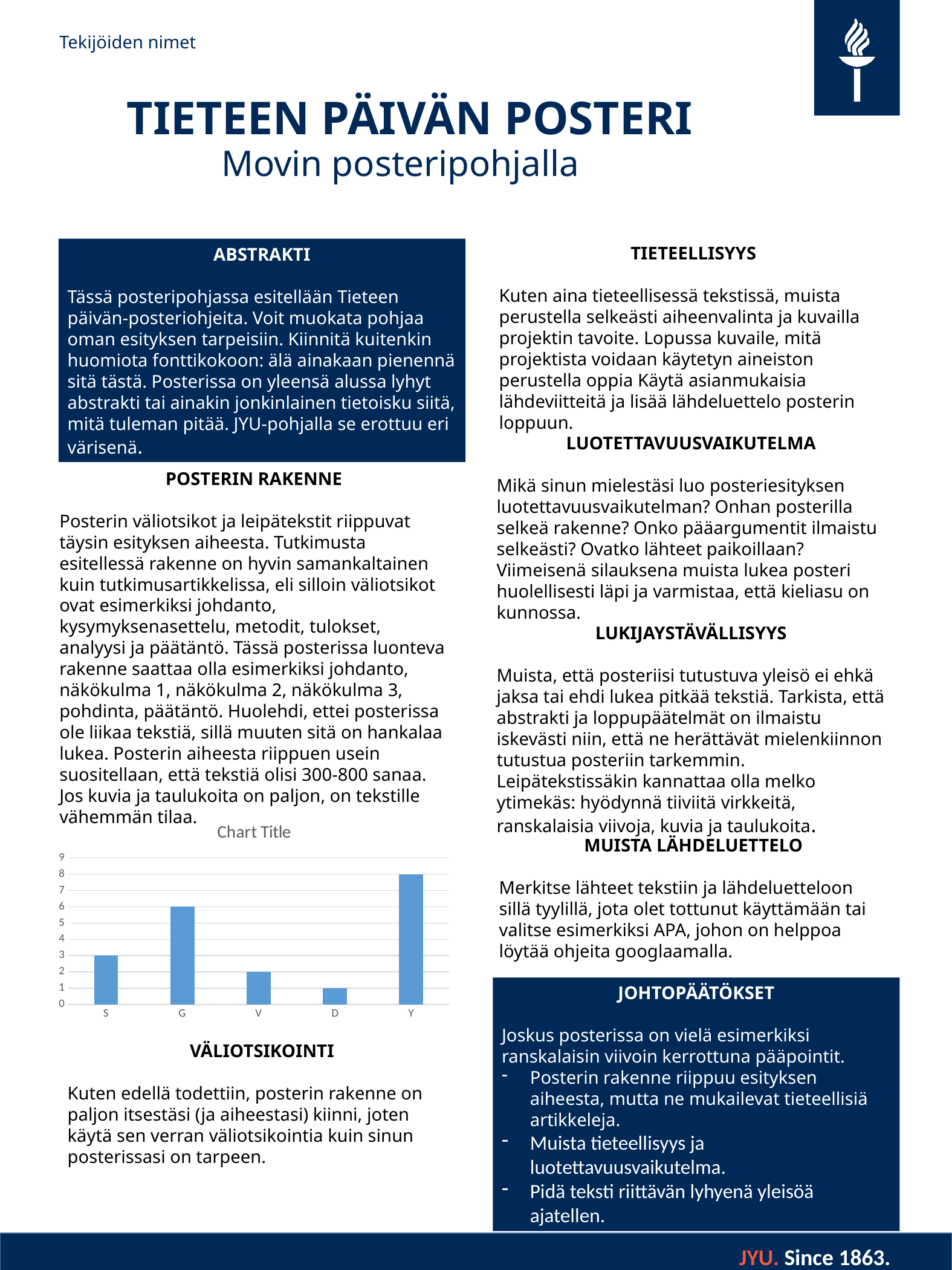
What is the value for category G in the chart? 6 Is the value for Y in the chart greater or less than 5? greater Which category has the lowest bar in the chart? D Is the value for D in the chart greater or less than 4? less What kind of chart is shown on the slide? bar chart What is the value for category Y in the chart? 8 Which category has the highest bar in the chart? Y What is the value for category S in the chart? 3 What is the title of the chart? Chart Title How many categories are shown on the x axis of the chart? 5 What is the difference between the values for Y and G in the chart? 2 Which is larger in the chart, the value for G or the value for V? G